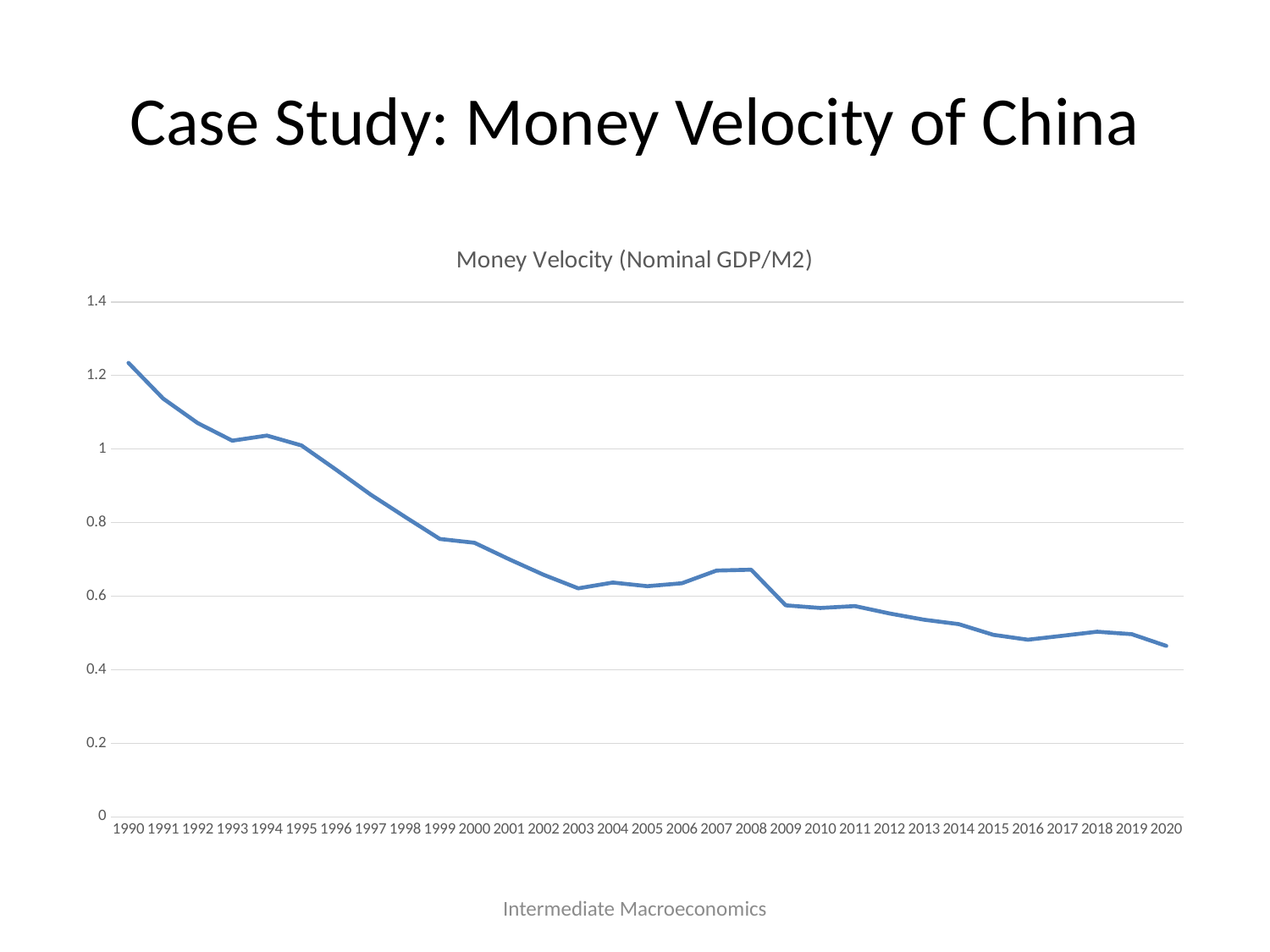
What kind of chart is shown on the slide? line chart Which year has the lowest money velocity in the chart? 2020 Overall, does money velocity rise or fall from 1990 to 2020? fall Is the money velocity for 2009 greater or less than 0.6? less Which year has the highest money velocity in the chart? 1990 Is the money velocity for 1990 greater or less than 1? greater Is the money velocity for 1999 greater or less than 0.8? less What is the title of the chart? Money Velocity (Nominal GDP/M2) How many years are plotted along the x axis of the chart? 31 Which year has the higher money velocity, 2008 or 2009? 2008